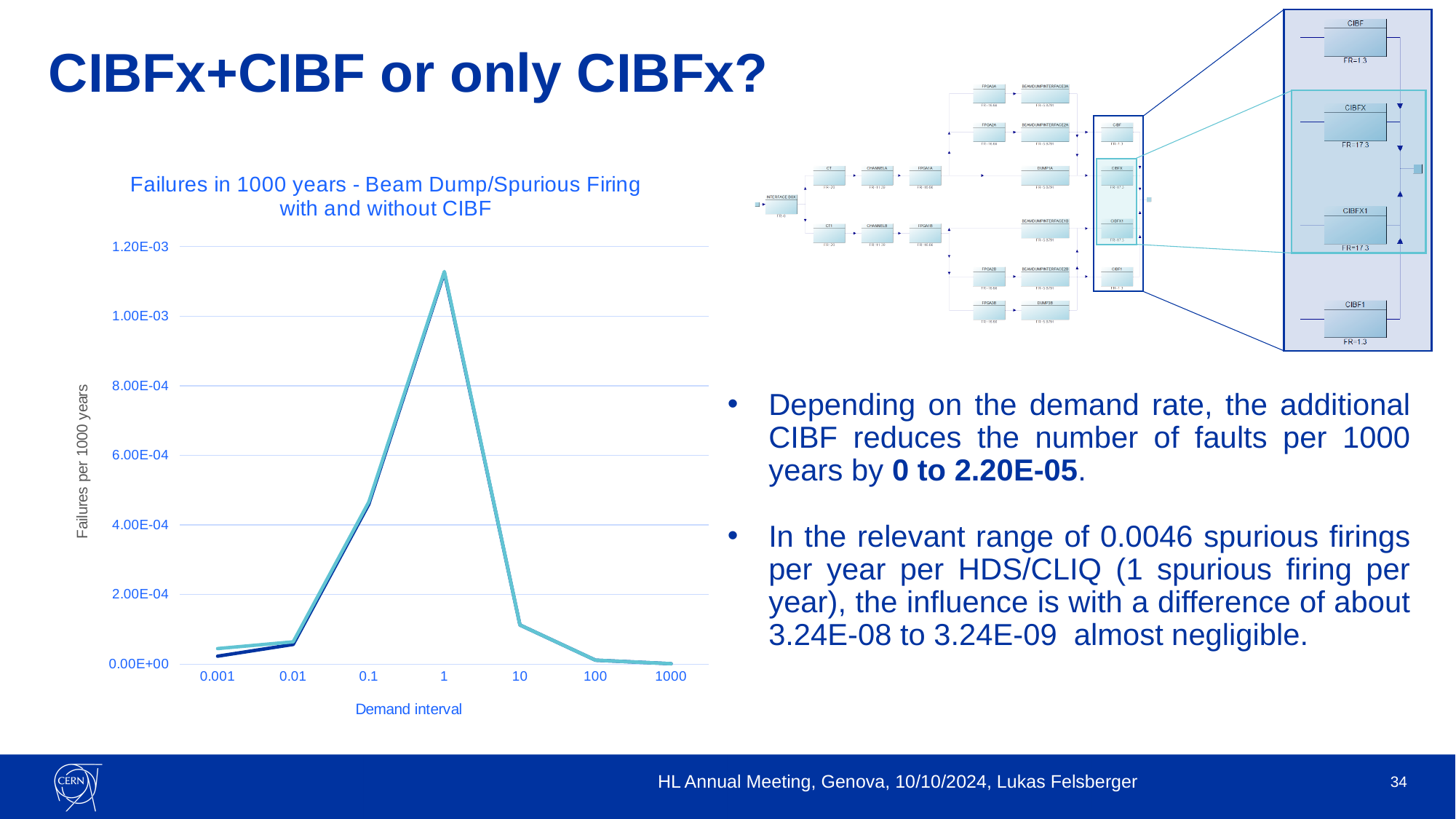
What kind of chart is shown on the slide? line chart Is the value at demand interval 0.1 greater or less than 4.00E-04? greater What is the title of the chart? Failures in 1000 years - Beam Dump/Spurious Firing with and without CIBF Is the value at demand interval 10 greater or less than 2.00E-04? less Which demand interval has the larger value, 0.1 or 10? 0.1 Is the value at demand interval 0.01 greater or less than 2.00E-04? less At which demand interval do the failures per 1000 years reach their highest value? 1 At which demand interval are the failures per 1000 years lowest? 1000 Do the failures per 1000 years rise or fall as the demand interval increases from 1 to 1000? fall How many demand interval values are marked on the x axis? 7 What is the label of the x axis of the chart? Demand interval